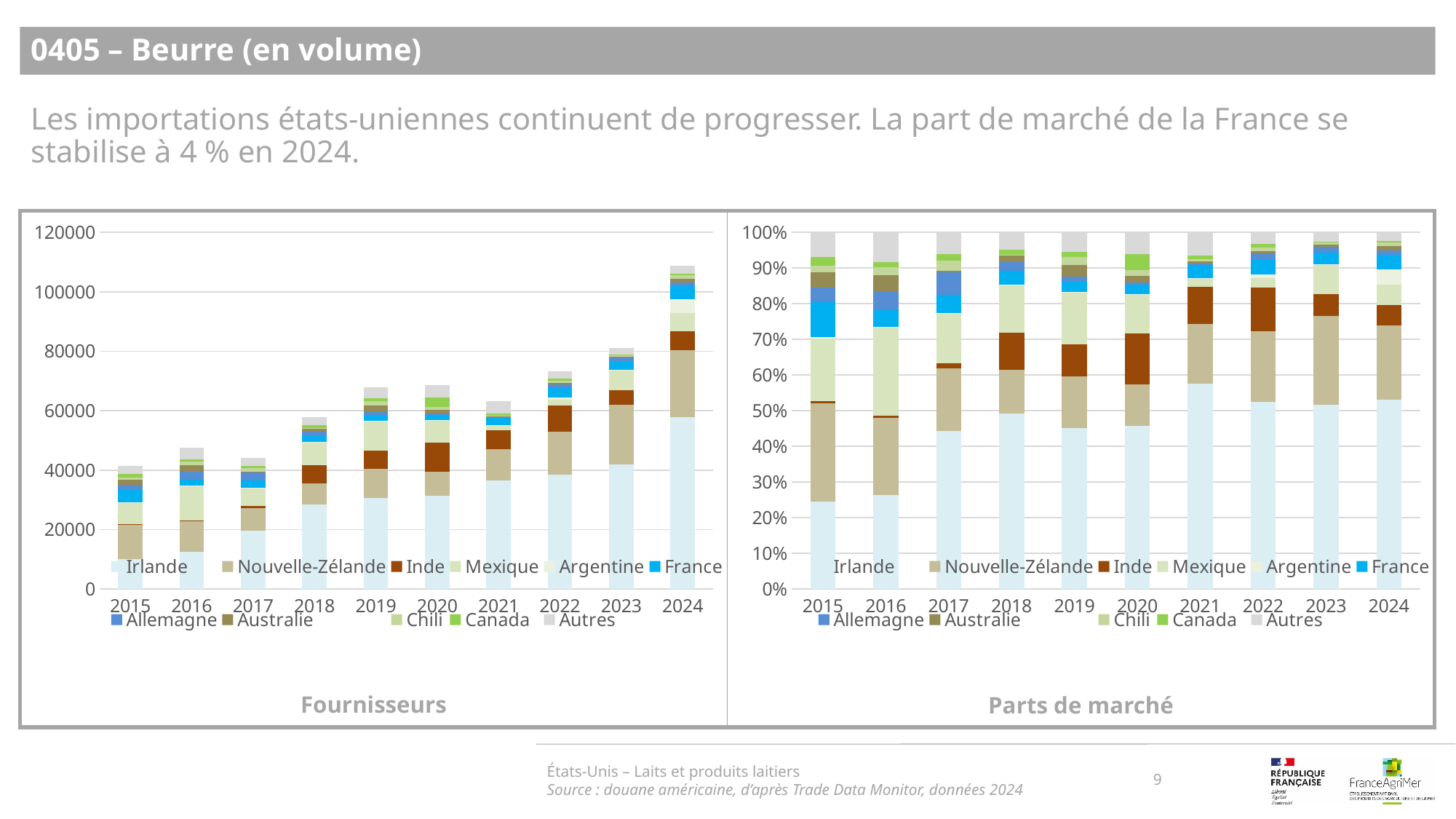
How many years are shown on the x axis of the 'Fournisseurs' chart? 10 In the 'Fournisseurs' chart, which year has the tallest total bar? 2024 In the 'Fournisseurs' chart, which year has the shortest total bar? 2015 What is the title of the chart on the right side of the slide? Parts de marché In the 'Fournisseurs' chart, which total bar is larger, 2023 or 2024? 2024 In the 'Fournisseurs' chart, do the total bars generally rise or fall from 2015 to 2024? rise In the 'Fournisseurs' chart, is the total bar for 2015 greater or less than 60000? less In the 'Fournisseurs' chart, is the total bar for 2024 greater or less than 100000? greater In the 'Parts de marché' chart, is the share of Irlande in 2015 greater or less than 30%? less How many series does the legend of the 'Parts de marché' chart list? 11 What kind of chart is the 'Fournisseurs' chart on the left? stacked bar chart